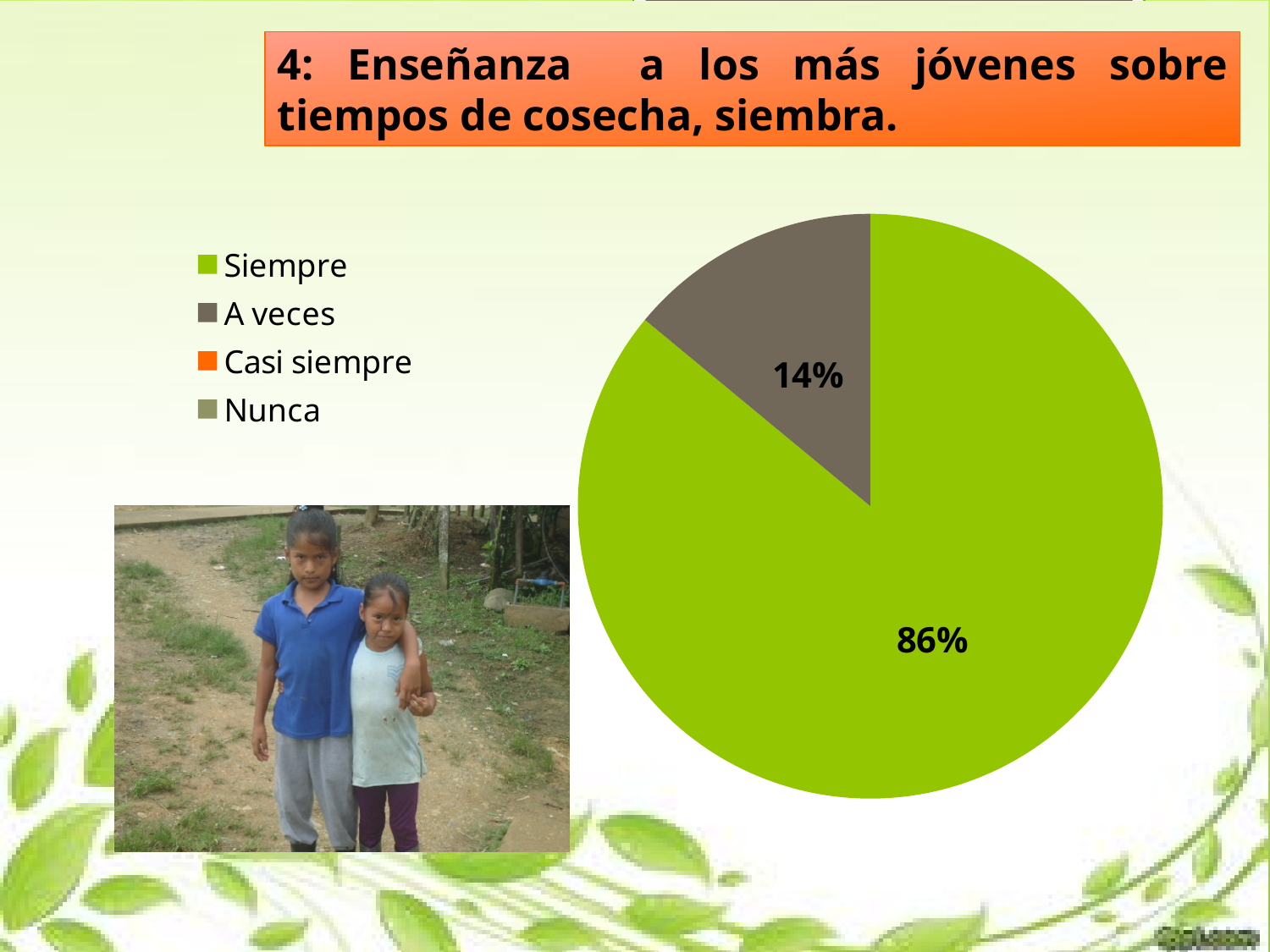
Which of the two labelled slices, Siempre or A veces, is smaller? A veces What is the title shown above the chart? 4: Enseñanza a los más jóvenes sobre tiempos de cosecha, siembra. How many entries does the legend list? 4 Which category has the largest slice of the pie? Siempre What kind of chart is shown on the slide? pie chart Which is larger, the Siempre slice or the A veces slice? Siempre What share of the pie is taken by the Siempre category? 86% What percentage of the pie does the A veces slice represent? 14% What percentage of the pie does the Siempre slice represent? 86% By how many percentage points does the Siempre slice exceed the A veces slice? 72 percentage points What colour is the Siempre slice in the pie chart? green How many slices with data labels are visible in the pie? 2